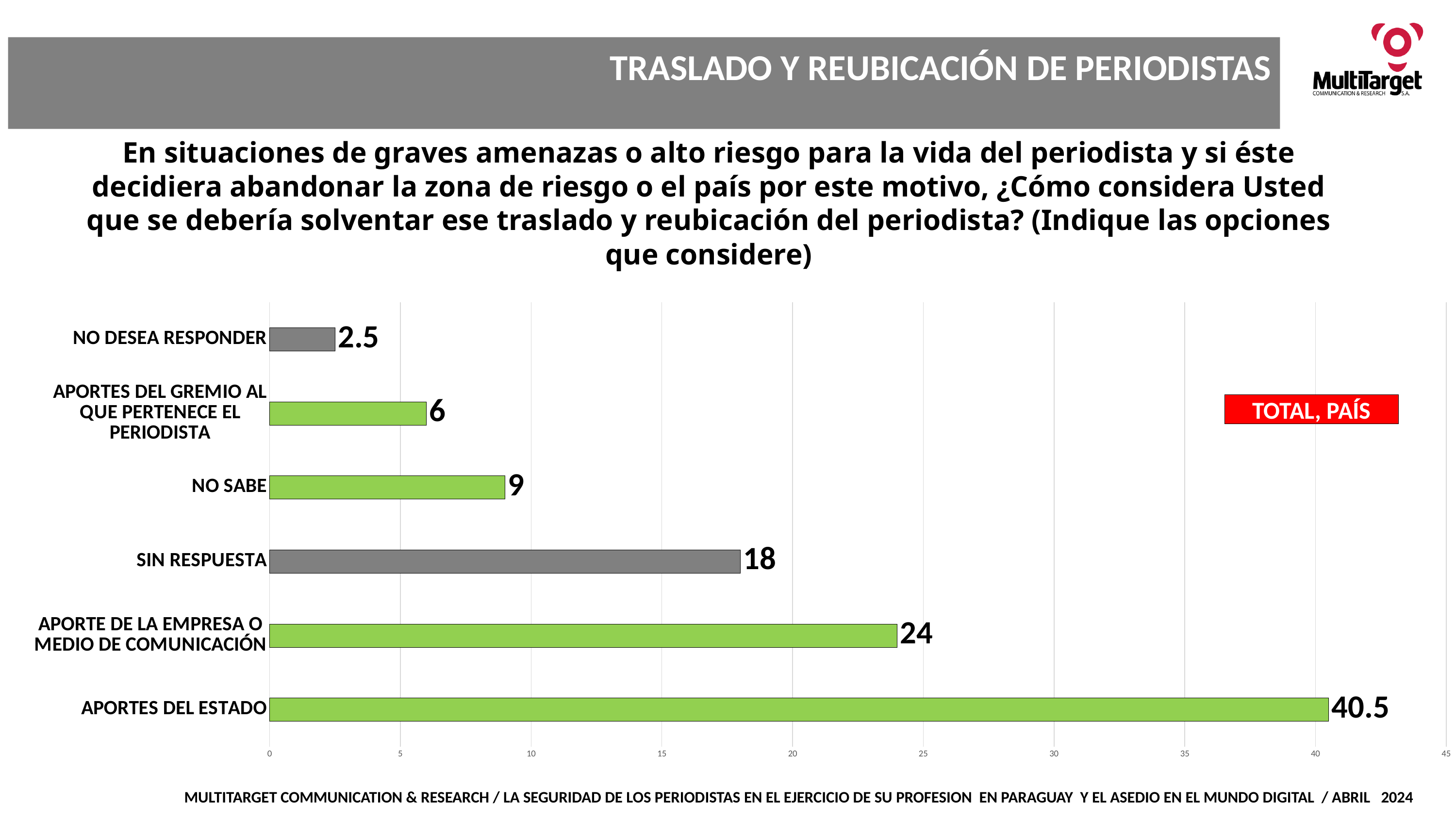
Which category has the lowest value? NO DESEA RESPONDER How many categories are shown in the chart? 6 What kind of chart is shown on the slide? bar chart What is the value for APORTE DE LA EMPRESA O MEDIO DE COMUNICACIÓN? 24 Which category has the highest value? APORTES DEL ESTADO What is the value for NO DESEA RESPONDER? 2.5 What does the red label next to the chart say? TOTAL, PAÍS What is the difference between the values for APORTES DEL ESTADO and APORTE DE LA EMPRESA O MEDIO DE COMUNICACIÓN? 16.5 What is the value for APORTES DEL ESTADO? 40.5 Which is larger, the value for NO SABE or the value for APORTES DEL GREMIO AL QUE PERTENECE EL PERIODISTA? NO SABE Is the value for SIN RESPUESTA greater or less than 20? less What is the value for SIN RESPUESTA? 18